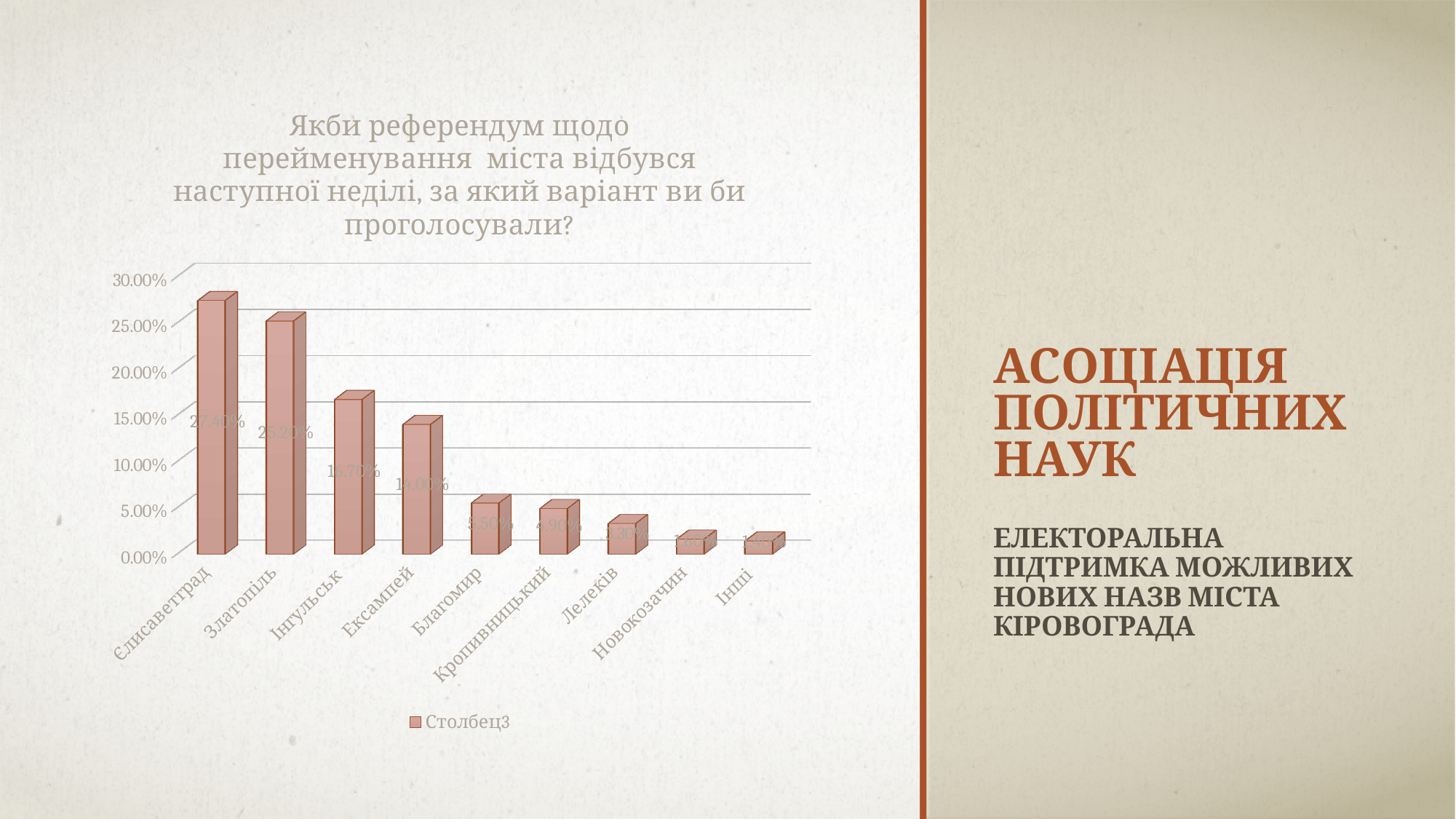
What is the value shown for Златопіль? 25.20% Is the value for Новокозачин greater or less than 5.00%? less What percentage of respondents would vote for Єлисаветград? 27.40% What is the value shown for Інгульськ? 16.70% Which option has the highest share of votes? Єлисаветград What is the difference between the values for Єлисаветград and Златопіль? 2.20% Which is larger, the value for Благомир or the value for Лелеків? Благомир How many categories are shown on the x axis? 9 What kind of chart is shown on the slide? bar chart What is the legend entry shown below the chart? Столбец3 What is the value shown for Кропивницький? 4.90% What is the value shown for Ексампей? 14.00%